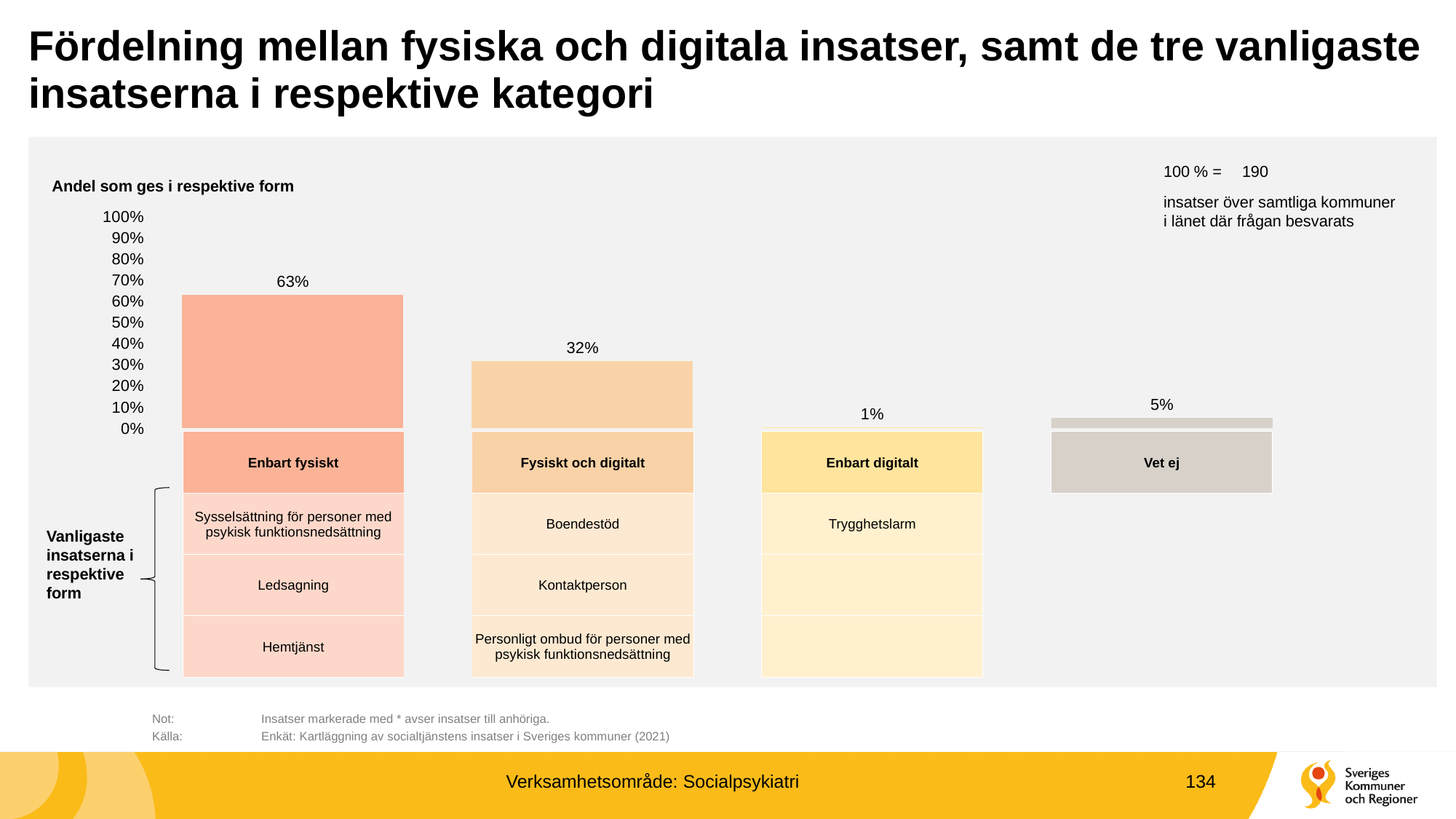
What is the value for Enbart digitalt? 1% What kind of chart is this? bar chart Which category has the lowest value? Enbart digitalt Is the value for Enbart fysiskt greater or less than 50%? greater What is the difference between the values for Enbart fysiskt and Fysiskt och digitalt? 31 percentage points What is the value for Enbart fysiskt? 63% Which category has the highest value? Enbart fysiskt What is the value for Fysiskt och digitalt? 32% Which is larger, the value for Vet ej or the value for Enbart digitalt? Vet ej How many categories are shown in the chart? 4 What does 100% correspond to according to the note on the chart? 190 insatser What is the value for Vet ej? 5%